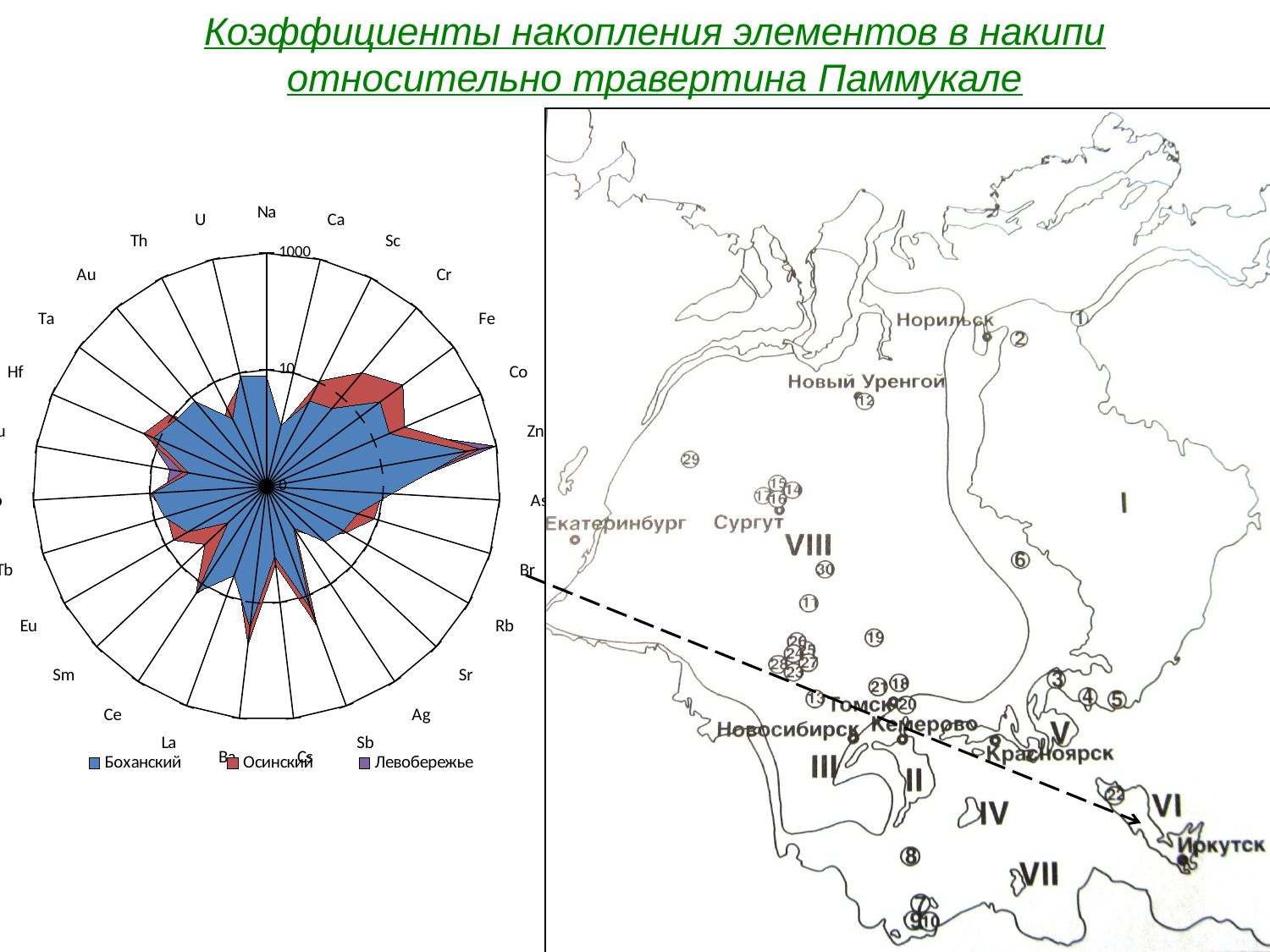
In the radar chart, is the value for Sb in the Осинский series greater or less than 10? greater How many series does the legend of the radar chart list? 3 What are the series names listed in the legend of the radar chart? Боханский, Осинский, Левобережье In the radar chart, is the value for Zn in the Боханский series greater or less than 10? greater Which series in the radar chart is drawn in blue? Боханский What kind of chart is shown on the left of the slide? radar chart